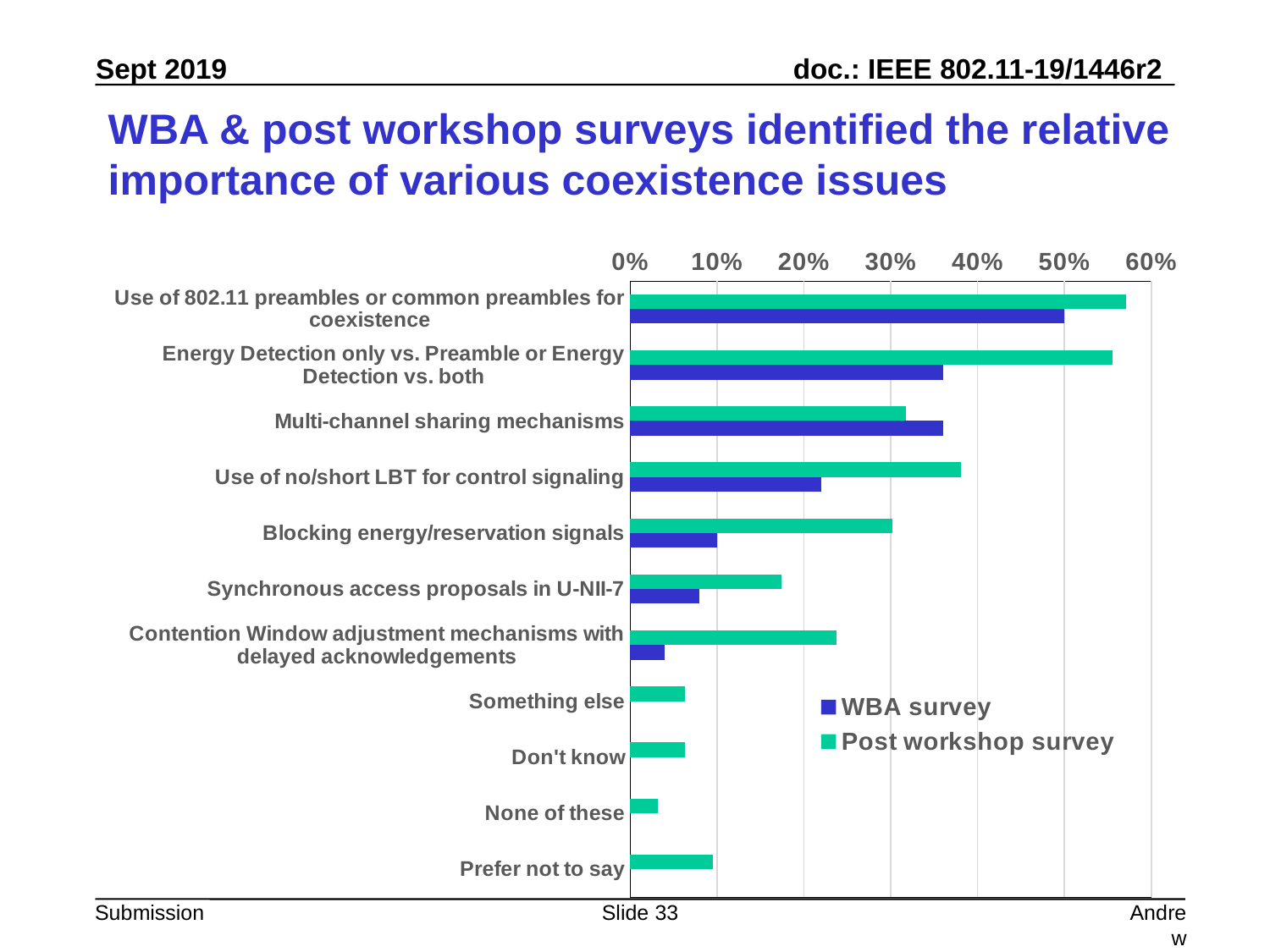
For 'Multi-channel sharing mechanisms', which series has the larger value, WBA survey or Post workshop survey? WBA survey What kind of chart is shown on the slide? bar chart How many categories are shown on the chart? 11 Is the WBA survey value for 'Blocking energy/reservation signals' greater or less than 20%? less Is the Post workshop survey value for 'Use of no/short LBT for control signaling' greater or less than 30%? greater What colour represents the WBA survey series in the legend? blue For 'Blocking energy/reservation signals', which series has the larger value, WBA survey or Post workshop survey? Post workshop survey Which category has the lowest value in the Post workshop survey series? None of these Which category has the highest value in the WBA survey series? Use of 802.11 preambles or common preambles for coexistence Is the Post workshop survey value for 'Use of 802.11 preambles or common preambles for coexistence' greater or less than 50%? greater How many series does the legend list? 2